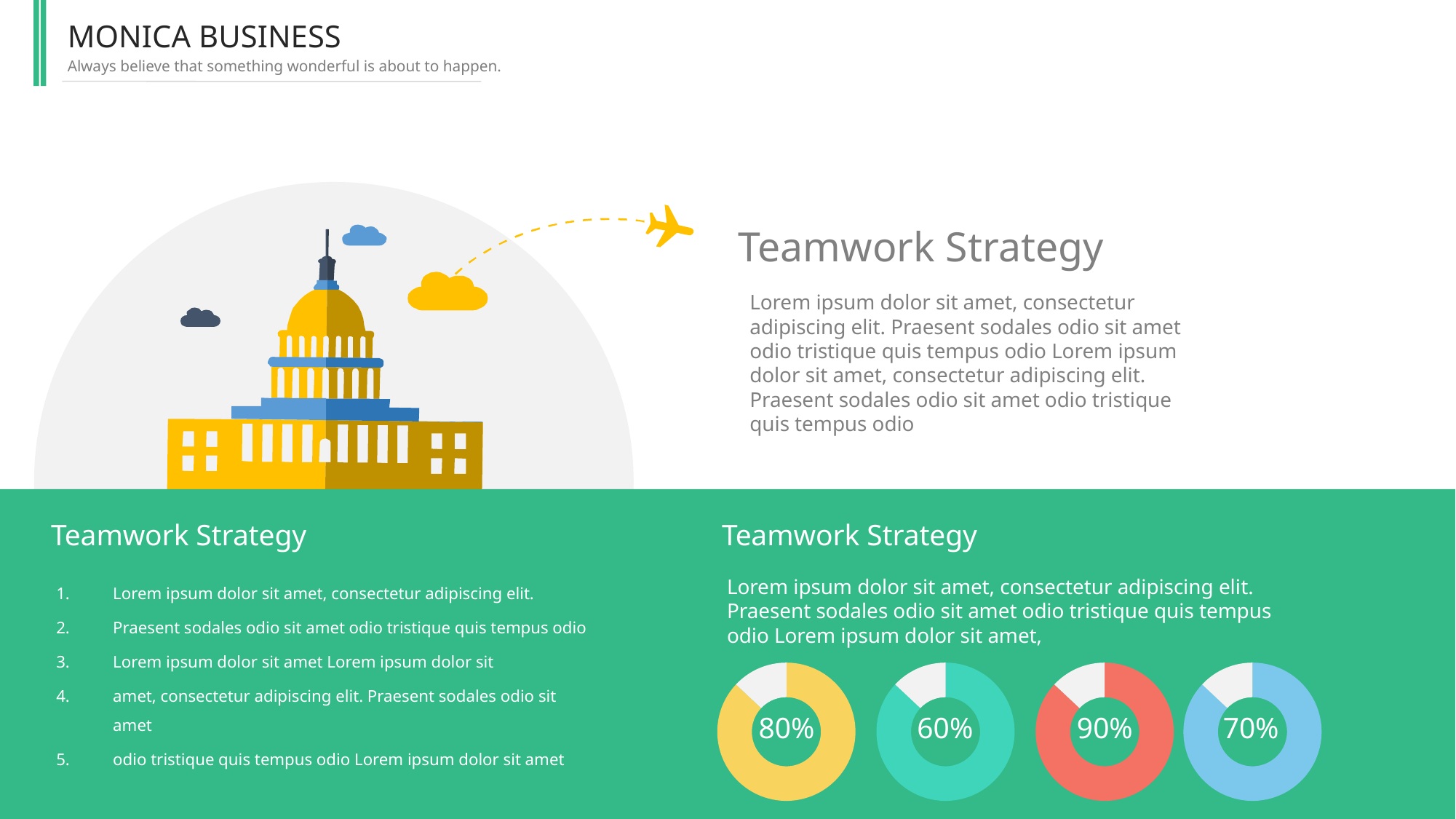
What value is shown in the teal donut chart (second from left)? 60% What colour is the donut chart that shows 60%? Teal What is the difference between the values in the yellow and blue donut charts? 10% What kind of charts are shown in the bottom-right section of the slide? Donut charts How many donut charts are shown on the slide? 4 Which is larger, the value in the yellow donut chart or the value in the blue donut chart? The yellow donut chart (80%) What value is shown in the yellow donut chart (leftmost)? 80% Which donut chart shows the highest percentage? The red one (90%) What is the difference between the value in the red donut chart and the value in the teal donut chart? 30% What value is shown in the blue donut chart (rightmost)? 70% What value is shown in the red donut chart (third from left)? 90% Which donut chart shows the lowest percentage? The teal one (60%)